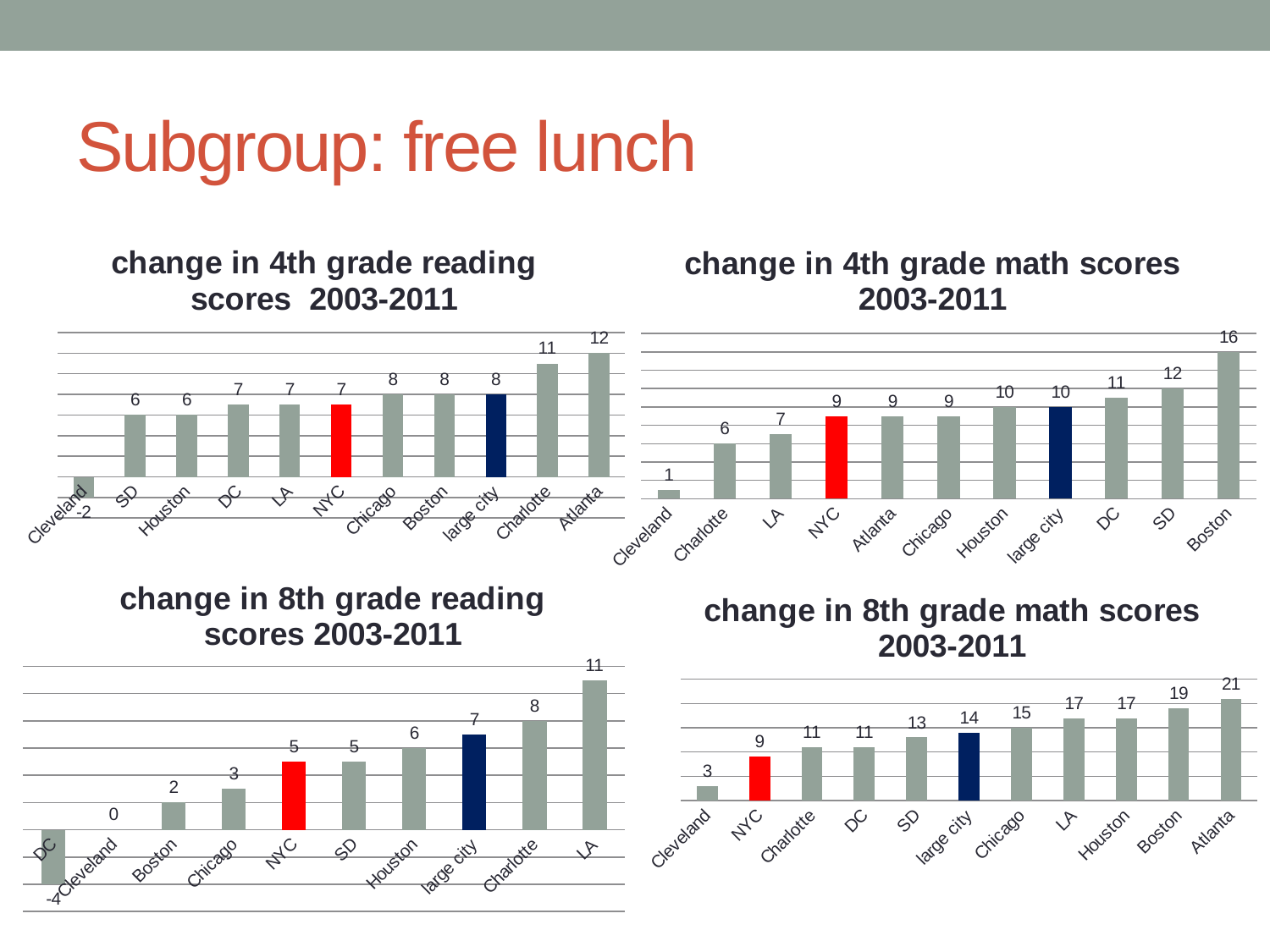
In the 'change in 4th grade reading scores 2003-2011' chart, which city has the highest value? Atlanta In the 'change in 4th grade math scores 2003-2011' chart, how many cities or groups are shown? 11 In the 'change in 4th grade math scores 2003-2011' chart, what is the difference between Boston and Cleveland? 15 In the 'change in 8th grade reading scores 2003-2011' chart, what is the value for DC? -4 In the 'change in 8th grade math scores 2003-2011' chart, what is the value for large city? 14 What type of chart is the 'change in 8th grade math scores 2003-2011' chart? Bar chart In the 'change in 4th grade reading scores 2003-2011' chart, which city has the lowest value? Cleveland In the 'change in 8th grade reading scores 2003-2011' chart, which city has the highest value? LA In the 'change in 8th grade math scores 2003-2011' chart, which is larger, the value for Atlanta or the value for NYC? Atlanta In the 'change in 4th grade reading scores 2003-2011' chart, what is the value for NYC? 7 In the 'change in 8th grade reading scores 2003-2011' chart, how many cities or groups are shown? 10 In the 'change in 4th grade math scores 2003-2011' chart, what is the value for Boston? 16